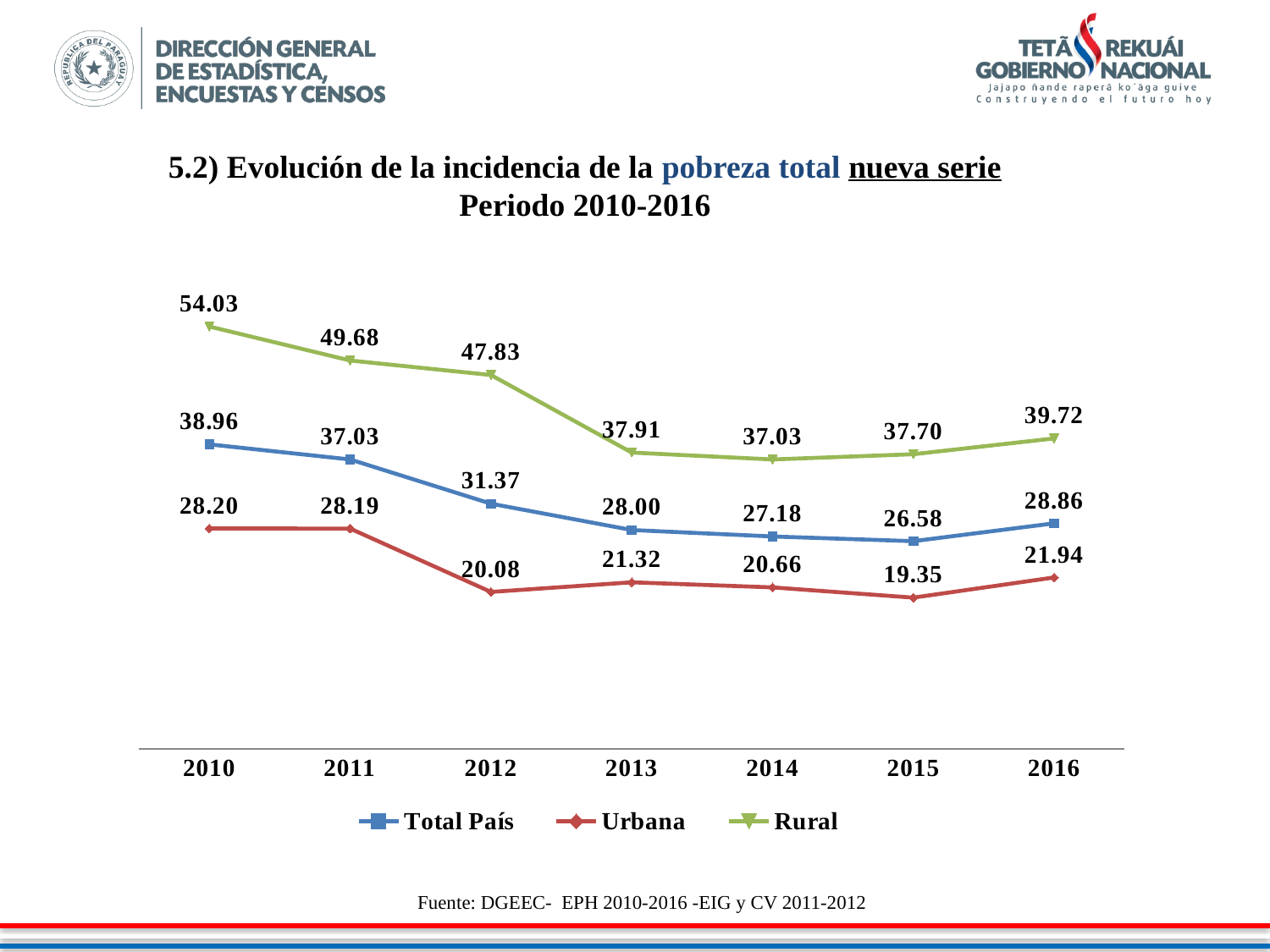
How many series does the legend list? 3 In which year is the Total País series at its highest? 2010 Which series is drawn in green? Rural What is the value for Total País in 2016? 28.86 Which is larger, the Total País value in 2012 or the Urbana value in 2010? Total País in 2012 In which year is the Rural series at its lowest? 2014 What is the value for Rural in 2010? 54.03 What type of chart is shown on the slide? Line chart What is the difference between the Rural and Urbana values in 2013? 16.59 What is the value for Urbana in 2015? 19.35 Does the Rural series rise or fall from 2010 to 2013? Fall How many years are plotted along the x axis? 7